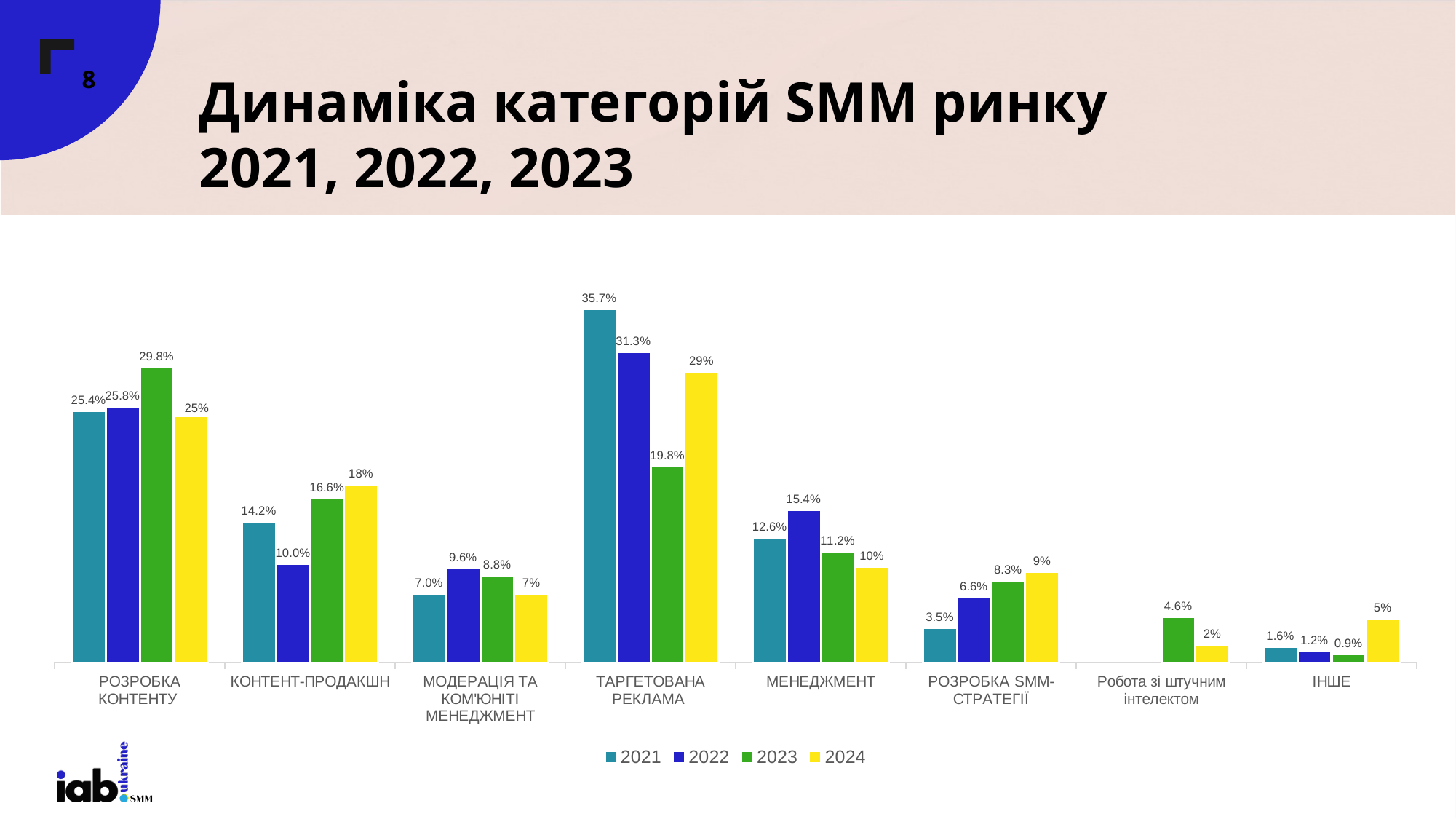
What is the value for Робота зі штучним інтелектом in 2024? 2% Do the values for РОЗРОБКА SMM-СТРАТЕГІЇ rise or fall from 2021 to 2024? rise Which colour represents the 2024 series in the legend? yellow Which category has the highest value in 2022? ТАРГЕТОВАНА РЕКЛАМА What is the value for РОЗРОБКА КОНТЕНТУ in 2023? 29.8% What is the value for ТАРГЕТОВАНА РЕКЛАМА in 2021? 35.7% How many series does the legend list? 4 What type of chart is shown on the slide? bar chart What is the difference between the 2021 and 2023 values for ТАРГЕТОВАНА РЕКЛАМА? 15.9% How many categories are shown on the x axis? 8 Which category has the lowest value in 2023? ІНШЕ Which is larger for КОНТЕНТ-ПРОДАКШН: the 2021 value or the 2024 value? 2024